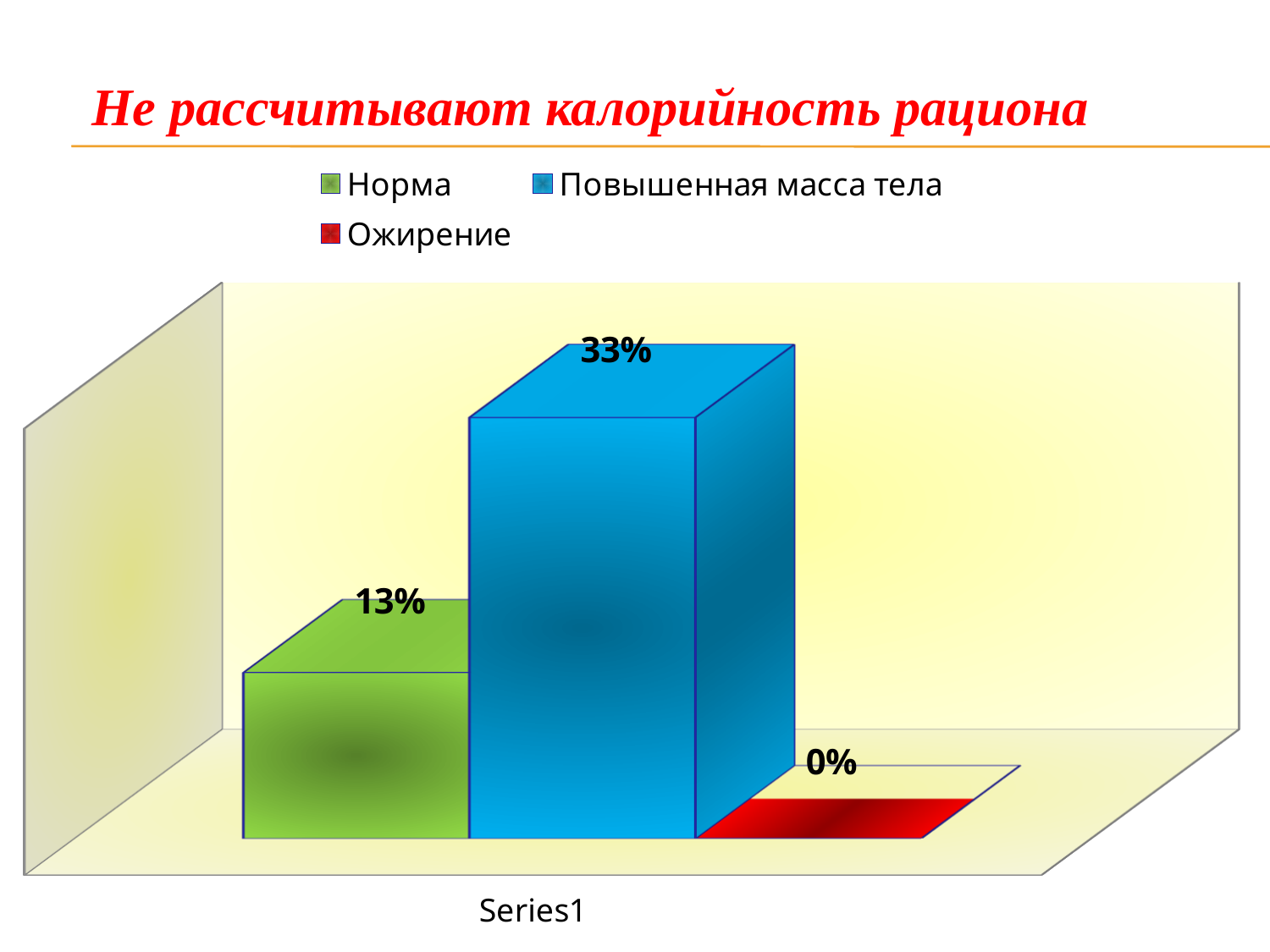
What is the value for Повышенная масса тела? 33% What is the category label shown on the x axis? Series1 What colour is the bar for Повышенная масса тела? blue Which series has the lowest value? Ожирение Which is larger, the value for Норма or the value for Повышенная масса тела? Повышенная масса тела How many series does the legend list? 3 What is the value for Ожирение? 0% What is the value for Норма? 13% What is the difference between the values for Повышенная масса тела and Норма? 20% Which series has the highest value? Повышенная масса тела What kind of chart is shown on the slide? bar chart What is the title of the slide? Не рассчитывают калорийность рациона